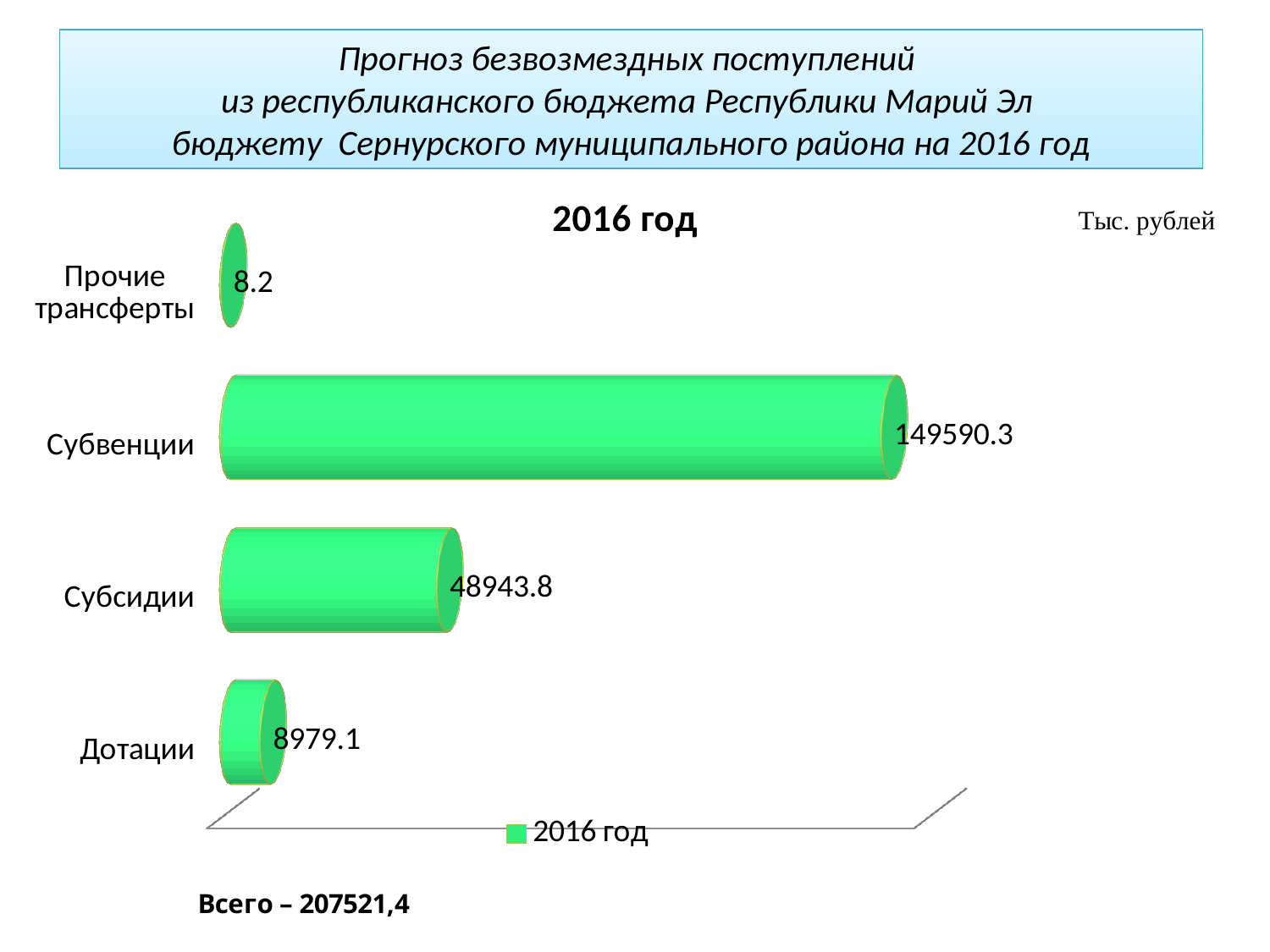
What is the value for Субсидии? 48943.8 Which is larger, the value for Дотации or the value for Субсидии? Субсидии What is the value for Дотации? 8979.1 What is the difference between the values for Субсидии and Дотации? 39964.7 What kind of chart is shown on the slide? Bar chart What is the difference between the values for Субвенции and Субсидии? 100646.5 Which category has the lowest value? Прочие трансферты Which category has the highest value? Субвенции How many categories are shown in the chart? 4 What is the title of the chart? 2016 год What is the value for Прочие трансферты? 8.2 What is the value for Субвенции? 149590.3